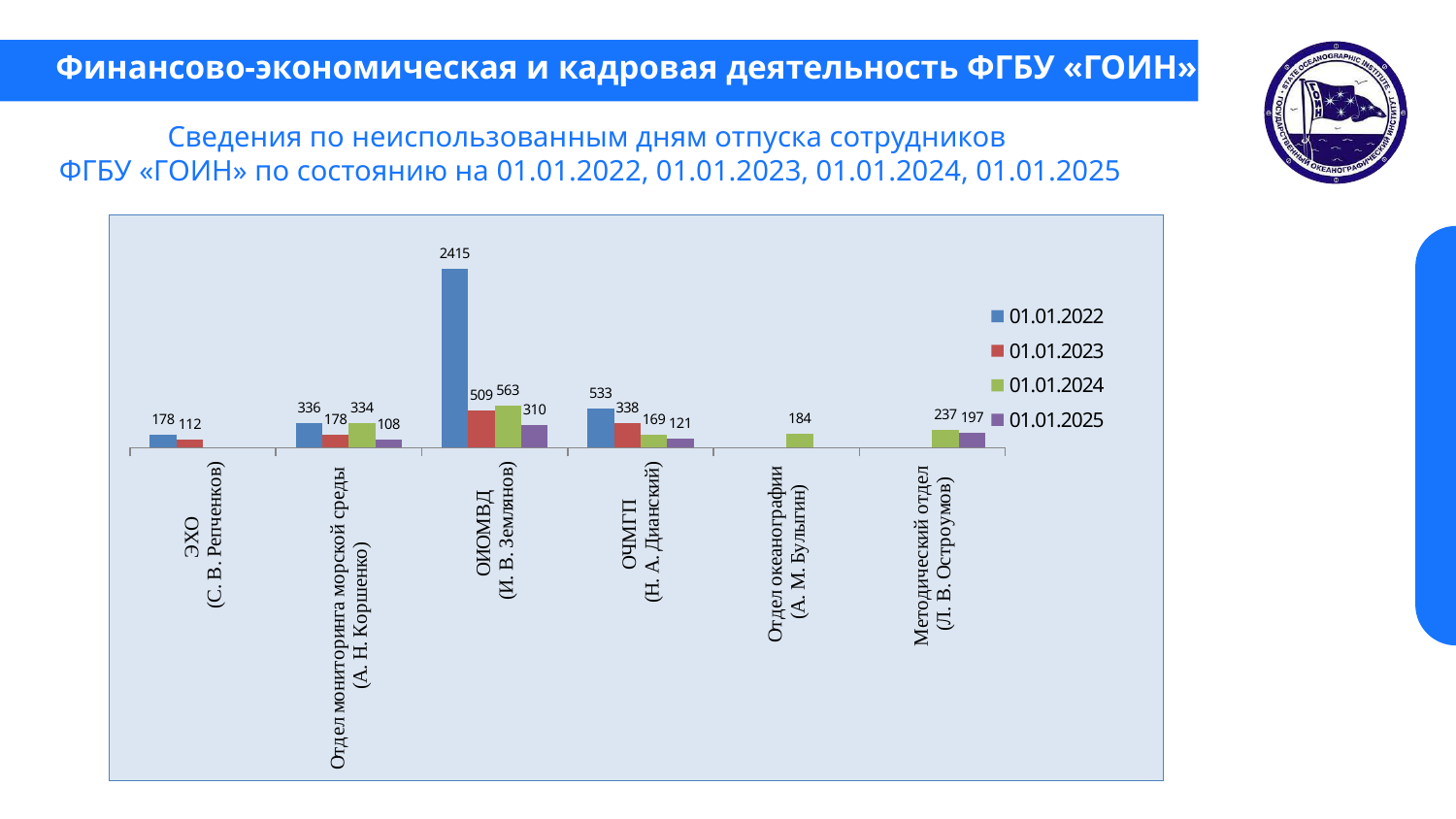
For ЭХО (С. В. Репченков), which is larger: the 01.01.2022 value or the 01.01.2023 value? 01.01.2022 Do the values for ОЧМГП (Н. А. Дианский) rise or fall from 01.01.2022 to 01.01.2025? fall What is the difference between the 01.01.2024 and 01.01.2023 values for ОИОМВД (И. В. Землянов)? 54 For Отдел мониторинга морской среды (А. Н. Коршенко), which date has the lowest value? 01.01.2025 What is the difference between the 01.01.2022 and 01.01.2025 values for ОЧМГП (Н. А. Дианский)? 412 What is the value for ОИОМВД (И. В. Землянов) on 01.01.2022? 2415 Which department has the highest value in the chart? ОИОМВД (И. В. Землянов) What is the value for Методический отдел (Л. В. Остроумов) on 01.01.2025? 197 What is the value for Отдел океанографии (А. М. Булыгин) on 01.01.2024? 184 How many departments are shown on the x axis? 6 How many series does the legend list? 4 What is the value for ОЧМГП (Н. А. Дианский) on 01.01.2023? 338